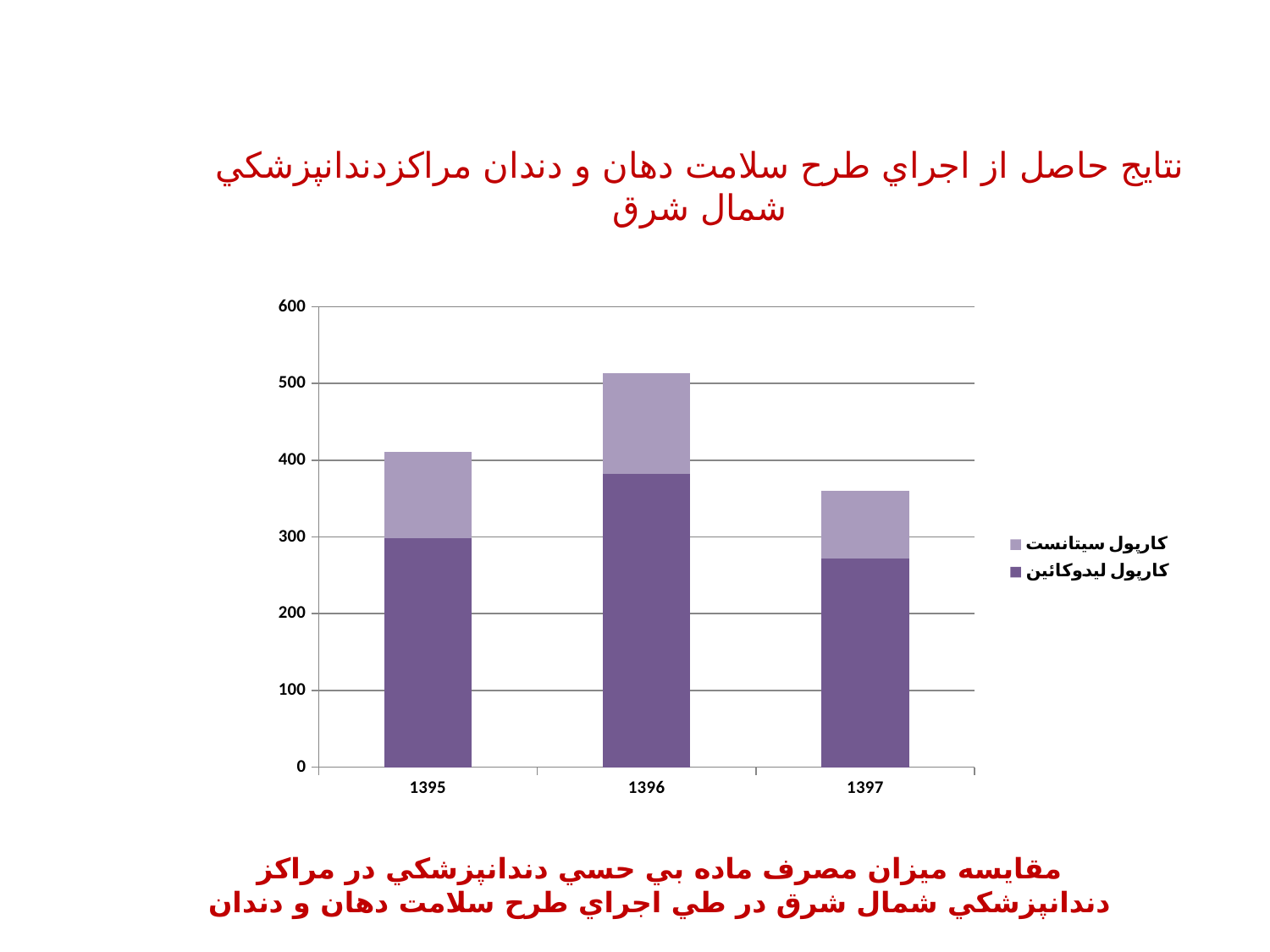
Which is larger, the کارپول لیدوکائین value for 1396 or for 1397? 1396 Which year has the shortest stacked bar in the chart? 1397 Which year has the tallest stacked bar in the chart? 1396 Is the total stacked value for 1396 greater or less than 400? greater Is the value of کارپول لیدوکائین for 1396 greater or less than 300? greater What kind of chart is shown on the slide? stacked bar chart Do the total stacked values rise or fall from 1396 to 1397? fall Which series is shown in the lighter purple colour at the top of each stacked bar? کارپول سیتانست Is the value of کارپول لیدوکائین for 1397 greater or less than 300? less How many categories (years) are shown on the x axis of the chart? 3 How many series does the chart's legend list? 2